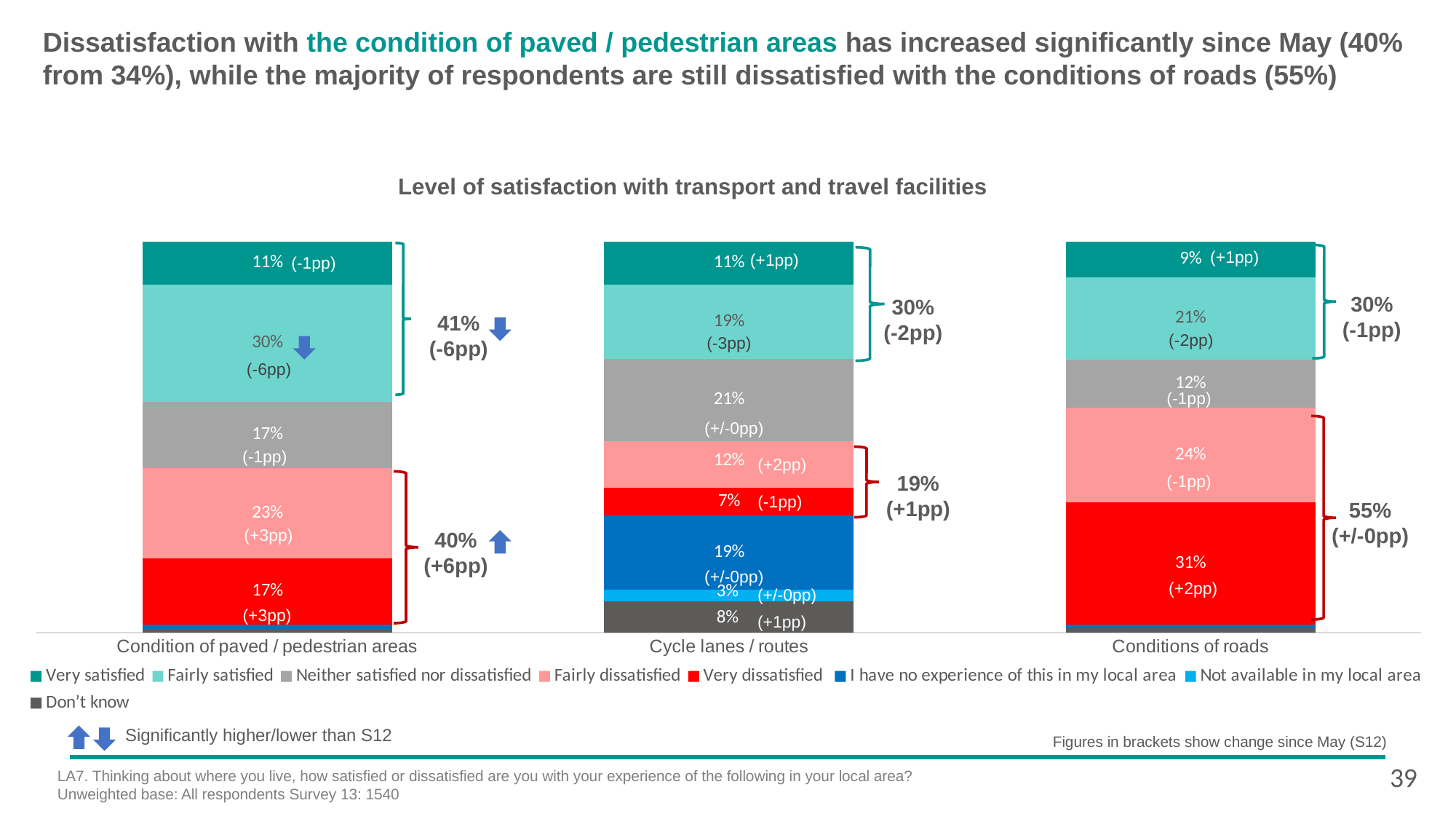
What is the combined dissatisfied (fairly plus very dissatisfied) total shown for conditions of roads? 55% Which category has the lowest 'Very satisfied' percentage? Conditions of roads How many series does the legend list? 8 How many categories are shown on the x axis of the chart? 3 Which is larger: the 'Neither satisfied nor dissatisfied' share for cycle lanes / routes or for conditions of roads? Cycle lanes / routes What percentage of respondents are very dissatisfied with the conditions of roads? 31% What is the change since May shown for 'Very dissatisfied' in the condition of paved / pedestrian areas? +3pp What percentage of respondents say they have no experience of cycle lanes / routes in their local area? 19% What is the difference between the 'Fairly dissatisfied' percentages for conditions of roads and cycle lanes / routes? 12 percentage points Which category has the highest 'Very dissatisfied' percentage? Conditions of roads What percentage of respondents are fairly satisfied with the condition of paved / pedestrian areas? 30% What kind of chart is shown on the slide? Stacked bar chart